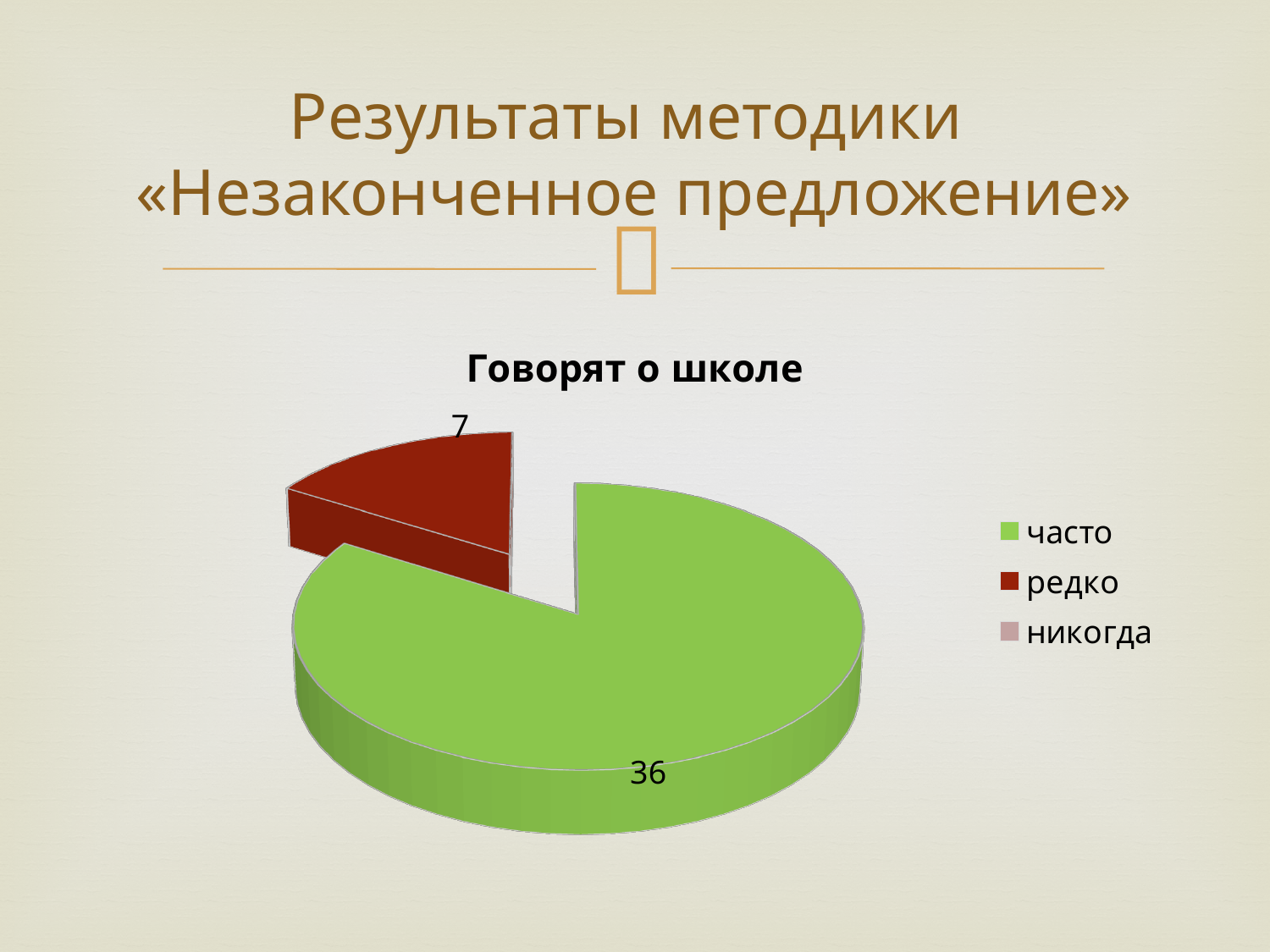
Which category has the largest slice of the pie? часто What is the value for the category "редко"? 7 How many categories does the legend list? 3 What is the title of the chart? Говорят о школе What is the value for the category "часто"? 36 What kind of chart is shown on the slide? pie chart Which is larger, the value for "часто" or the value for "редко"? часто Which colour represents the category "редко" in the chart? dark red What is the difference between the values for "часто" and "редко"? 29